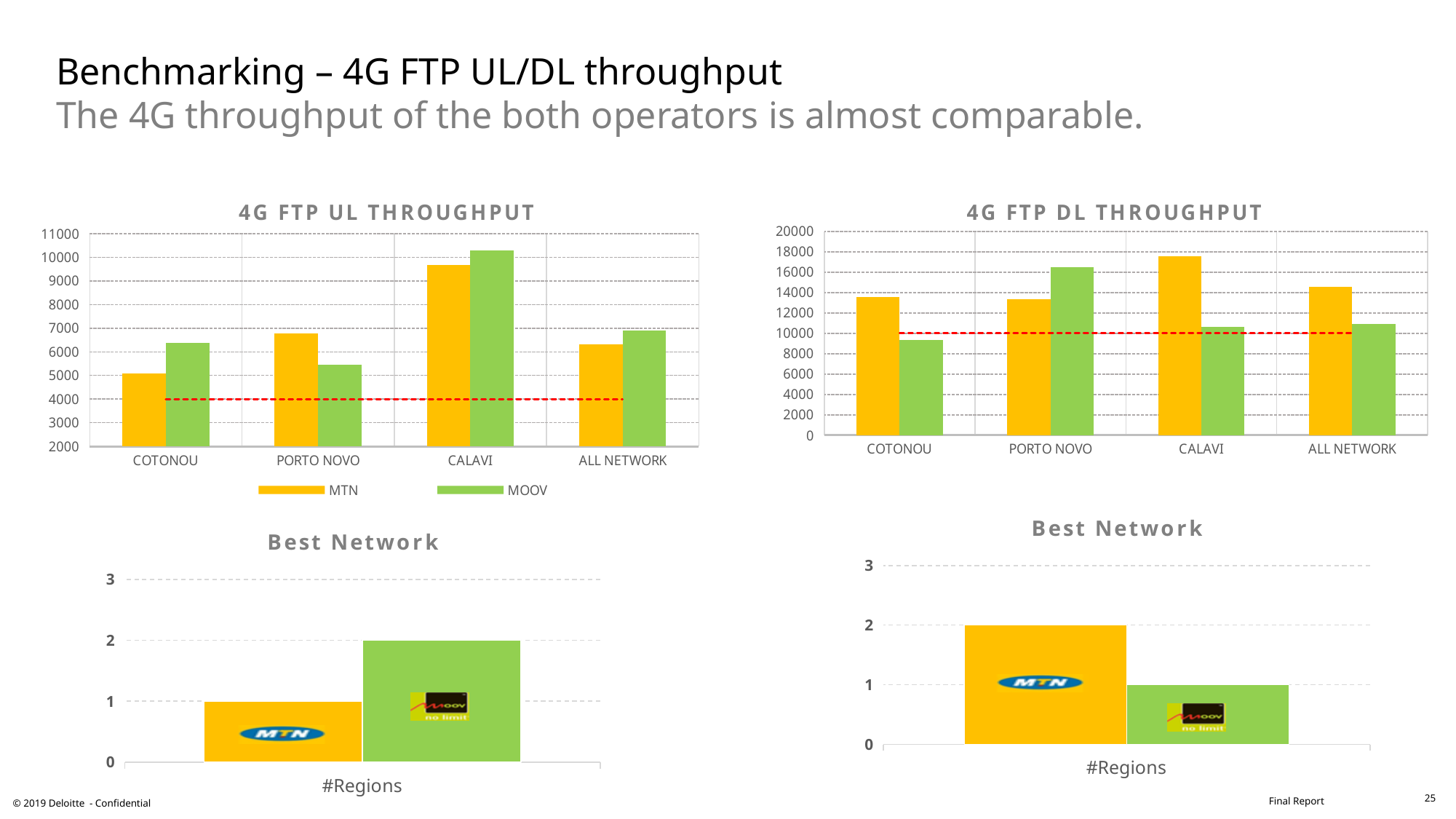
In the 4G FTP DL THROUGHPUT chart, is the MOOV value for COTONOU greater or less than 10000? less What kind of chart is the 4G FTP UL THROUGHPUT chart? bar chart How many categories are shown on the x axis of the 4G FTP DL THROUGHPUT chart? 4 In the 4G FTP DL THROUGHPUT chart, which category has the highest MOOV value? PORTO NOVO In the 4G FTP DL THROUGHPUT chart, for CALAVI, which is larger: MTN or MOOV? MTN In the 4G FTP UL THROUGHPUT chart, which category has the lowest MTN value? COTONOU In the 4G FTP UL THROUGHPUT chart, which category has the highest MTN value? CALAVI In the 4G FTP UL THROUGHPUT chart, for COTONOU, which is larger: MTN or MOOV? MOOV How many series does the legend of the 4G FTP UL THROUGHPUT chart list? 2 In the 4G FTP DL THROUGHPUT chart, which category has the lowest MOOV value? COTONOU In the 4G FTP UL THROUGHPUT chart, is the MTN value for CALAVI greater or less than 9000? greater In the Best Network chart at the bottom left of the slide, what is the value for MOOV? 2